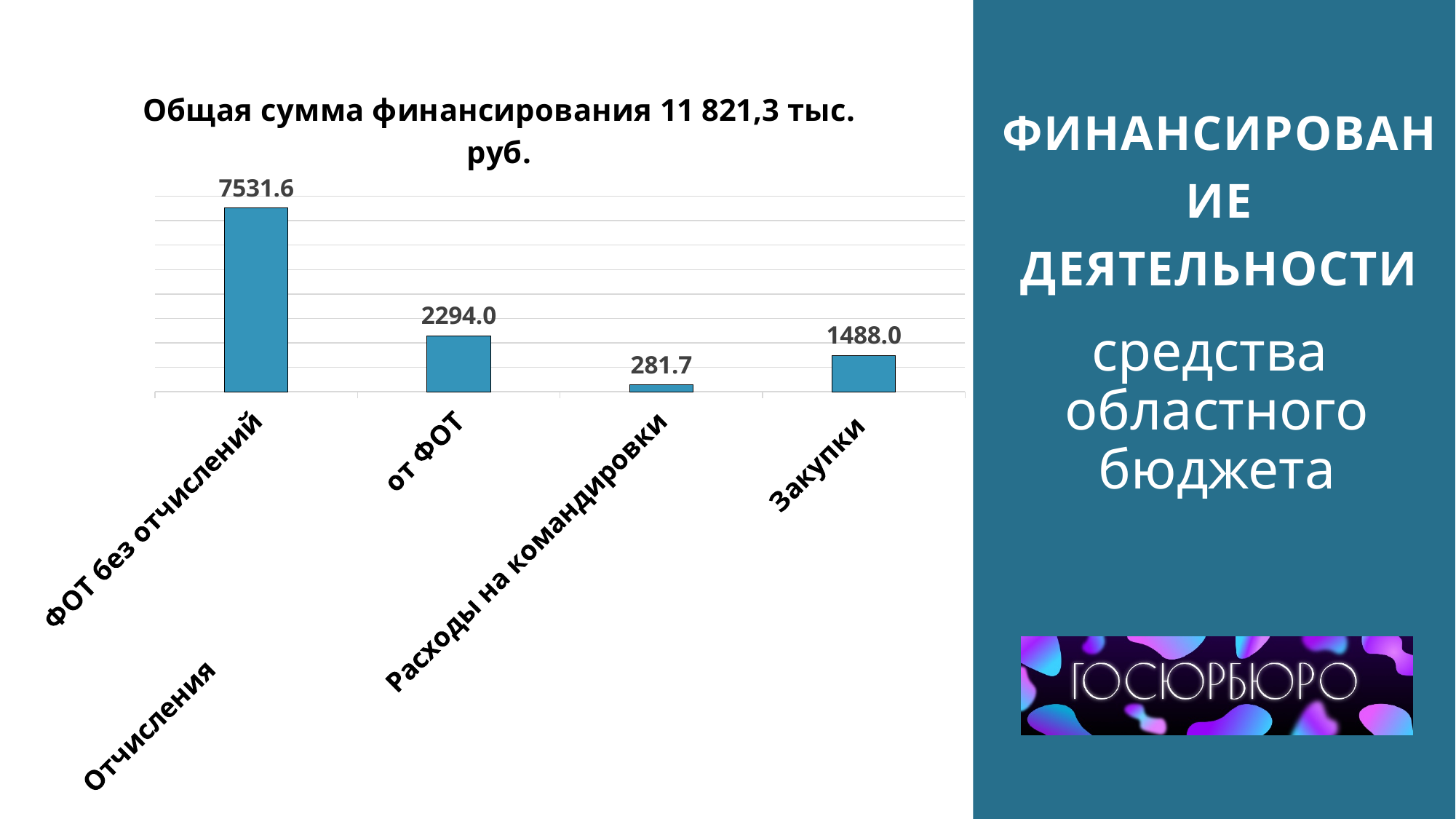
What is the value for Отчисления от ФОТ? 2294.0 What is the value for Закупки? 1488.0 Which category has the highest value? ФОТ без отчислений What is the value for Расходы на командировки? 281.7 Which is larger, the value for Отчисления от ФОТ or the value for Закупки? Отчисления от ФОТ What is the difference between the values for Закупки and Расходы на командировки? 1206.3 What is the title of the chart? Общая сумма финансирования 11 821,3 тыс. руб. How many categories are shown in the chart? 4 What is the difference between the values for ФОТ без отчислений and Отчисления от ФОТ? 5237.6 What kind of chart is shown on the slide? Bar chart Which category has the lowest value? Расходы на командировки What is the value for ФОТ без отчислений? 7531.6